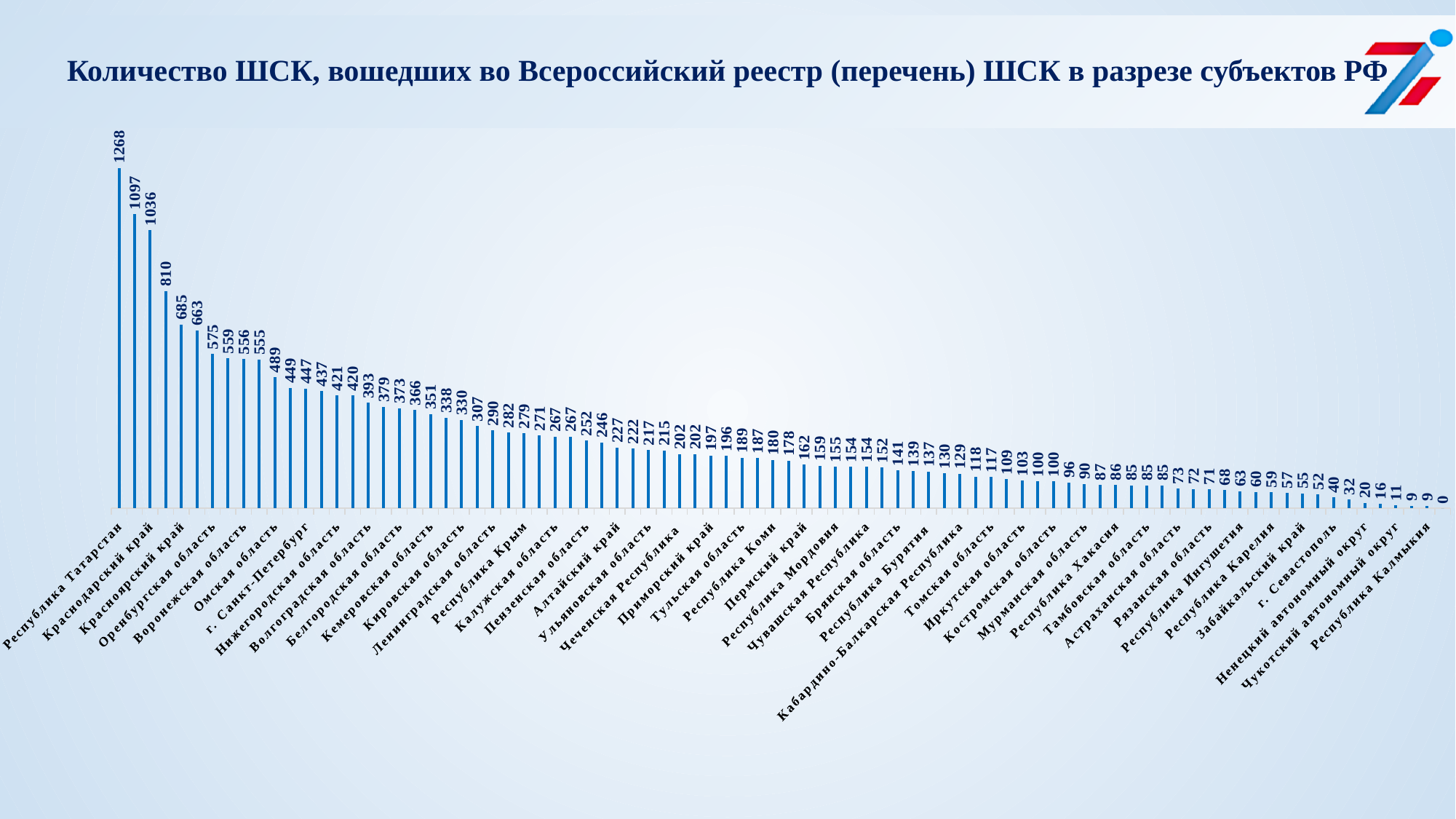
What is the difference between the values for Республика Татарстан and Республика Калмыкия? 1259 What is the value shown for Республика Татарстан? 1268 What kind of chart is shown on the slide? Bar chart What is the second-highest value labelled in the chart? 1097 What is the title of the chart? Количество ШСК, вошедших во Всероссийский реестр (перечень) ШСК в разрезе субъектов РФ What is the value shown for Республика Калмыкия? 9 What colour are the bars in the chart? Blue Which region has the highest number of ШСК in the chart? Республика Татарстан Do the values rise or fall from left to right along the x axis? Fall Which is larger, the value for Республика Татарстан or the value for Республика Калмыкия? Республика Татарстан